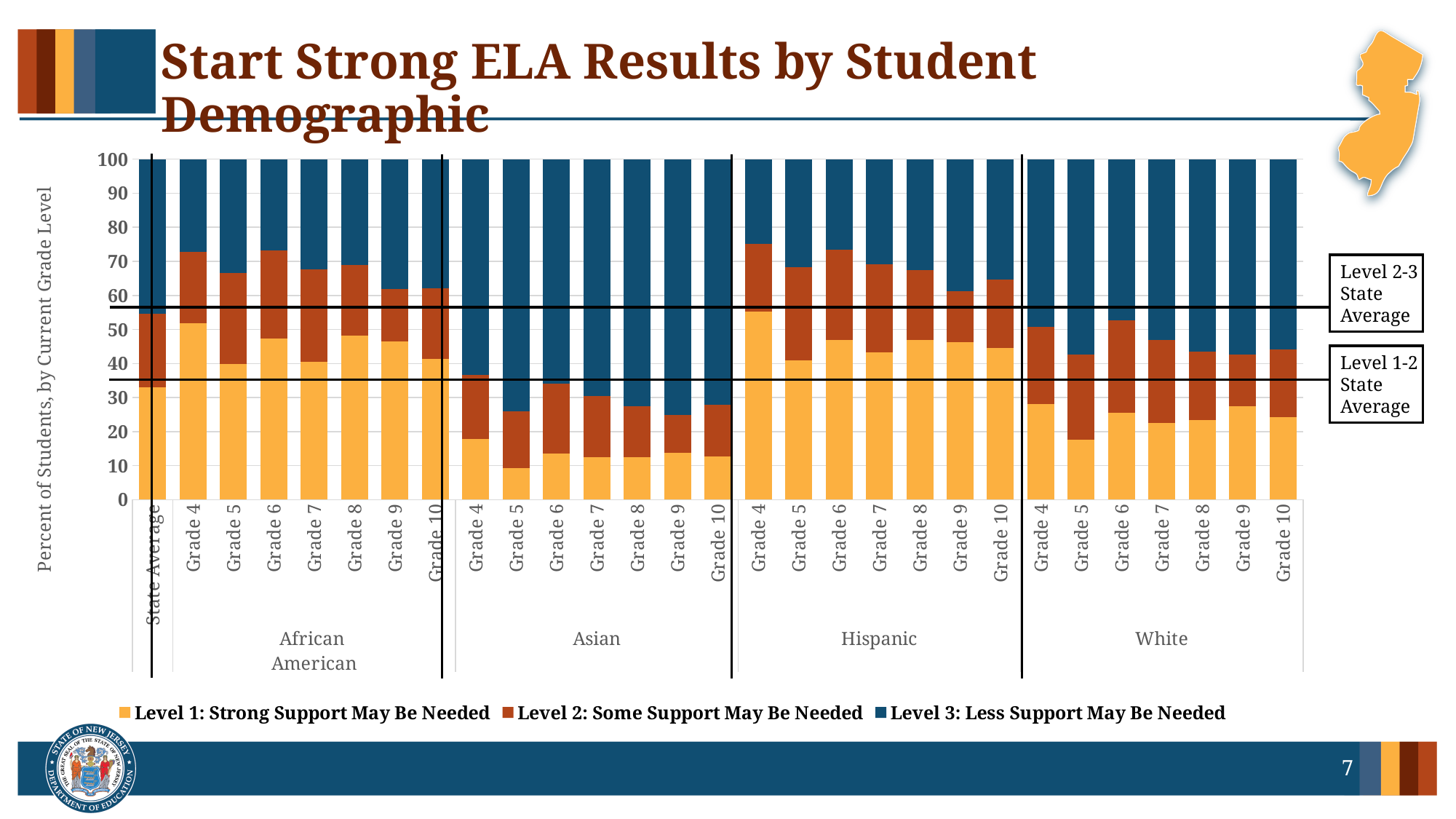
How many grade levels are shown for each demographic group? 7 What kind of chart is shown on the slide? Stacked bar chart Which is larger, the Level 1 value for Asian Grade 5 or for Hispanic Grade 4? Hispanic Grade 4 How many series does the legend list? 3 Is the Level 1 value for Hispanic Grade 4 greater or less than 50? greater What value does each stacked bar total on the y axis? 100 Which grade in the Asian group has the lowest Level 1 value? Grade 5 What is the label of the y axis? Percent of Students, by Current Grade Level How many demographic groups are shown along the x axis besides the State Average? 4 Is the Level 1 value for White Grade 5 greater or less than 20? less What is the title of the chart? Start Strong ELA Results by Student Demographic